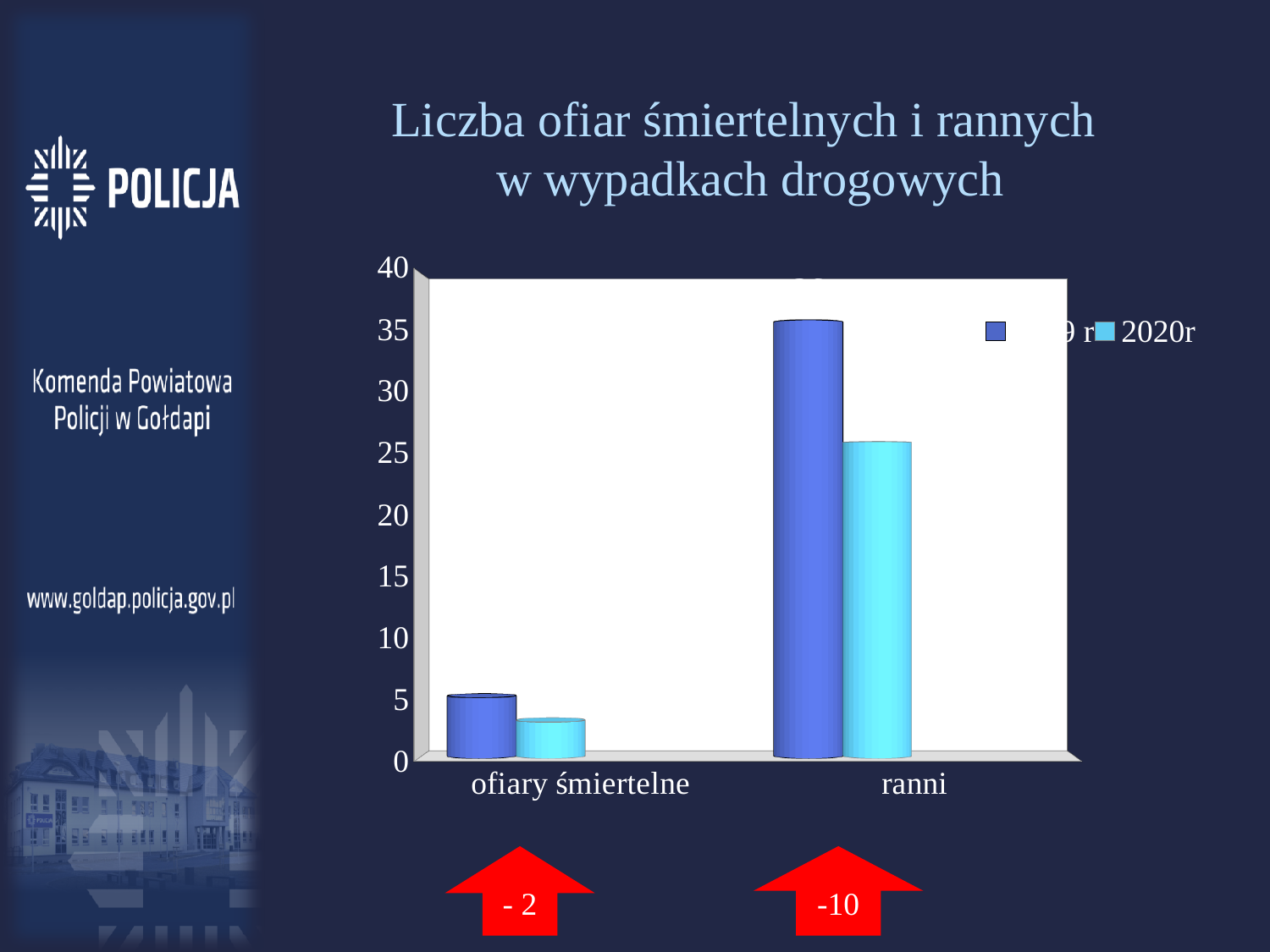
Is the 2020r value for ranni greater or less than 20? greater How many categories are shown on the x axis of the chart? 2 Is the 2020r value for ranni greater or less than 30? less For the category ofiary śmiertelne, which series has the larger value: the dark blue series or the light blue 2020r series? the dark blue series Which category has the higher value for the 2020r series? ranni Is the dark blue series value for ranni greater or less than 30? greater What is the title of the chart? Liczba ofiar śmiertelnych i rannych w wypadkach drogowych For the category ranni, which series has the larger value: the dark blue series or the light blue 2020r series? the dark blue series How many series does the chart's legend list? 2 Which bar in the chart has the lowest value? ofiary śmiertelne, 2020r What kind of chart is shown on the slide? bar chart